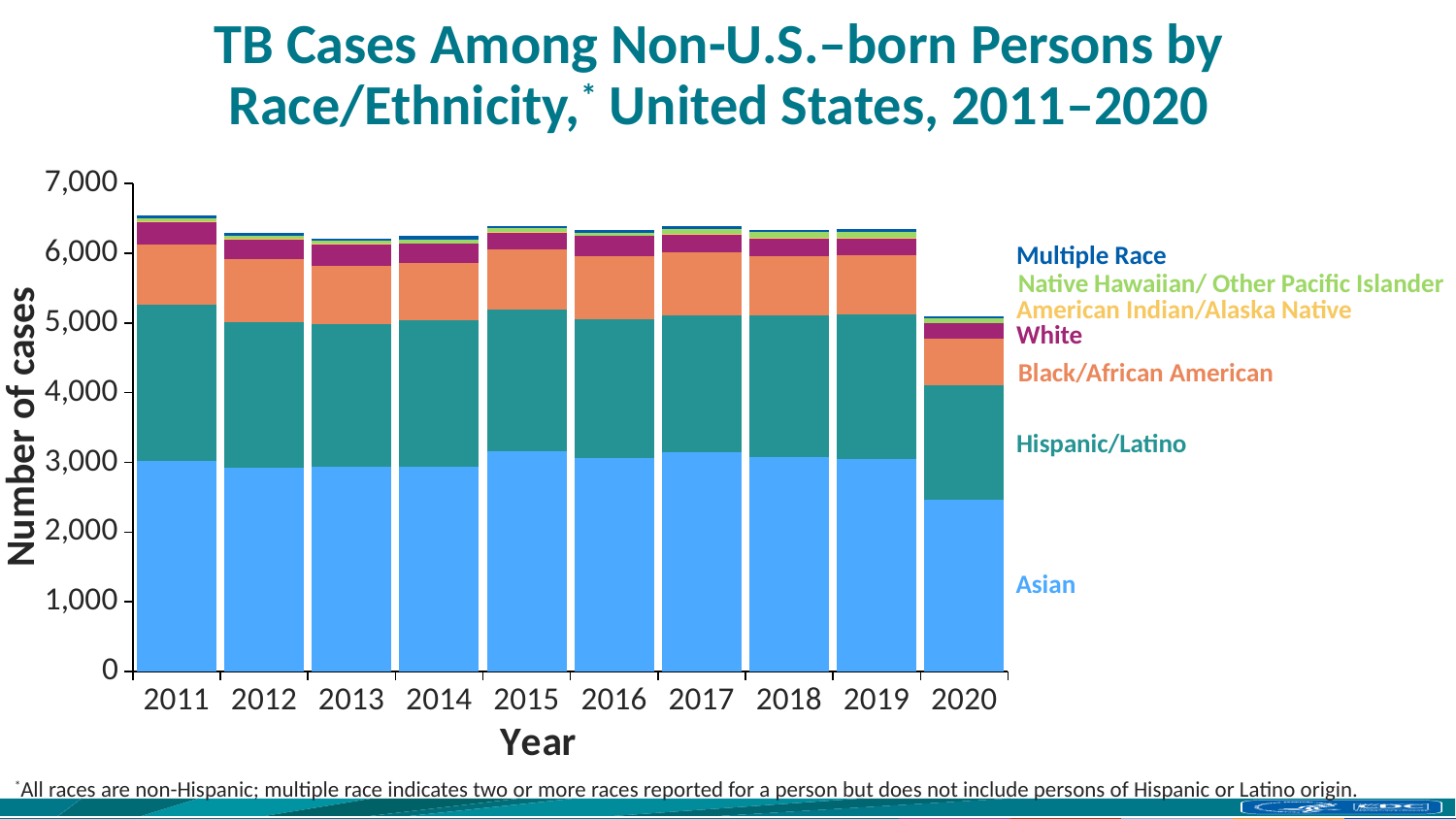
Is the total number of cases in 2020 greater or less than 6,000? less Which year has the highest total number of TB cases among non-U.S.-born persons? 2011 What is the label on the y axis of the chart? Number of cases Is the number of Asian cases in 2020 greater or less than 3,000? less How many years are shown along the x axis of the chart? 10 Which year has the larger total number of cases, 2011 or 2020? 2011 Which year has the lowest total number of TB cases among non-U.S.-born persons? 2020 Does the total number of cases rise or fall from 2019 to 2020? fall What kind of chart is shown on the slide? Stacked bar chart Is the total number of cases in 2011 greater or less than 6,000? greater How many race/ethnicity series does the legend list? 7